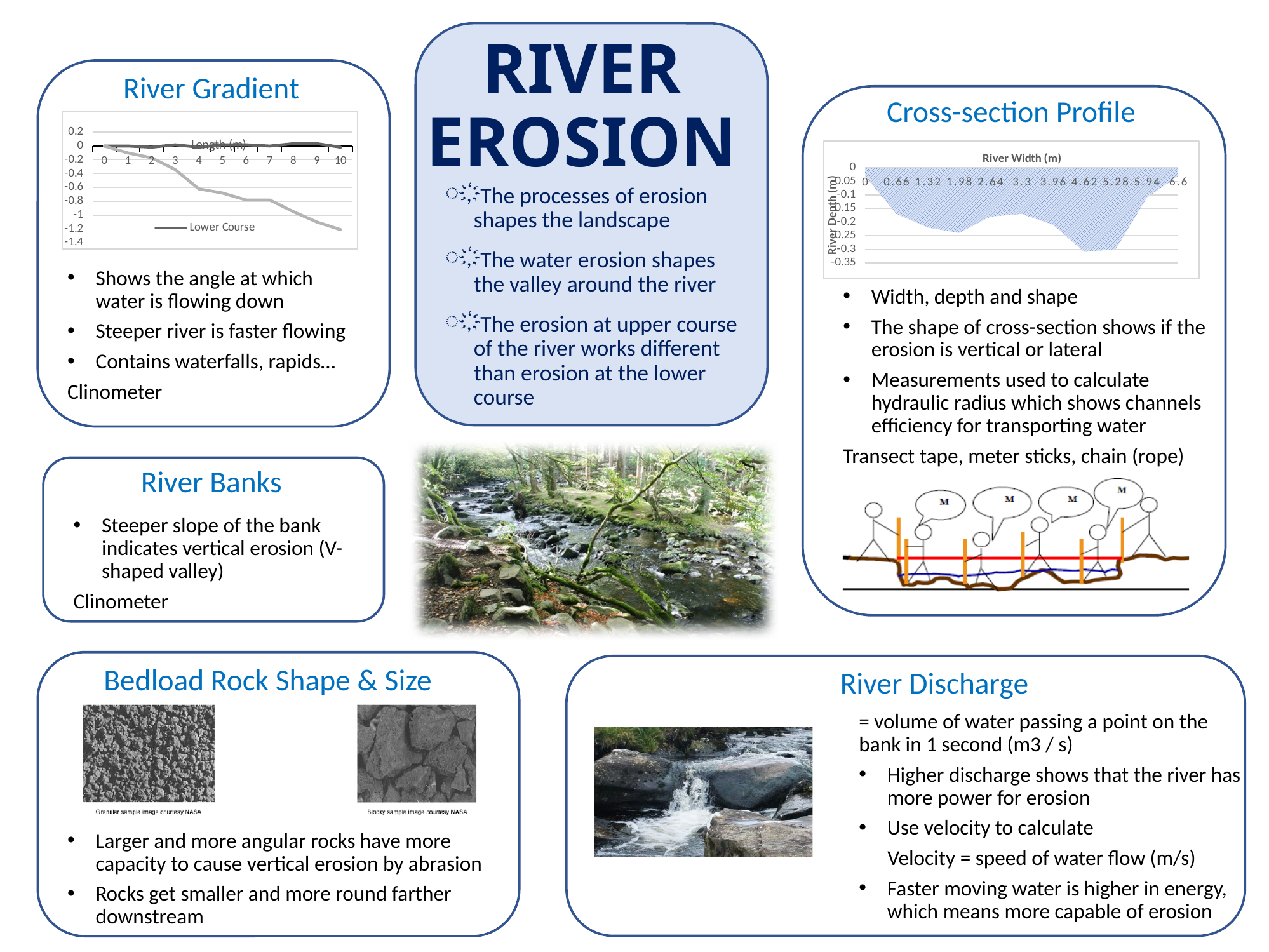
In the Cross-section Profile chart, is the river depth at width 5.28 greater or less than -0.25? less In the Cross-section Profile chart, what is the title of the horizontal axis? River Width (m) In the River Gradient chart, what series name does the legend show? Lower Course In the River Gradient chart, is the Lower Course value at length 10 greater or less than -1? greater In the River Gradient chart, is the Lower Course value at length 2 greater or less than -0.4? greater In the Cross-section Profile chart, how many river width values are labelled on the x axis? 11 In the River Gradient chart, how many length values are labelled on the x axis? 11 What type of chart is shown in the Cross-section Profile panel? area chart What type of chart is shown in the River Gradient panel? line chart